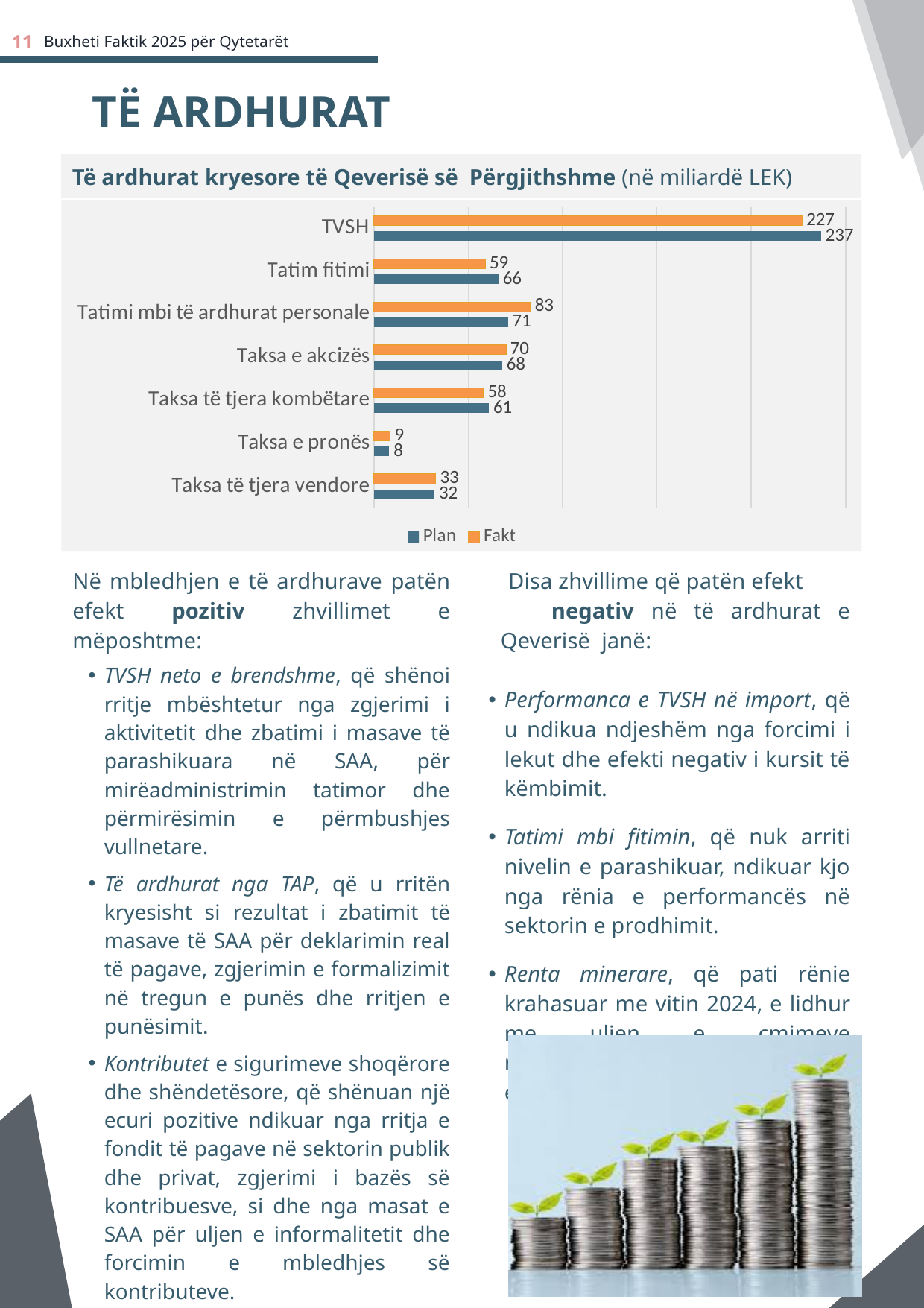
What is the Fakt value for Tatimi mbi të ardhurat personale? 83 What is the Plan value for Taksa e pronës? 8 What is the difference between the Fakt and Plan values for Tatimi mbi të ardhurat personale? 12 For Tatim fitimi, which is larger, the Plan value or the Fakt value? Plan What type of chart is shown on the slide? Bar chart How many series does the legend list? 2 What is the Plan value for TVSH? 237 Which category has the highest Plan value? TVSH How many categories are shown in the chart? 7 Which category has the lowest Fakt value? Taksa e pronës What is the Fakt value for TVSH? 227 What is the difference between the Plan and Fakt values for TVSH? 10